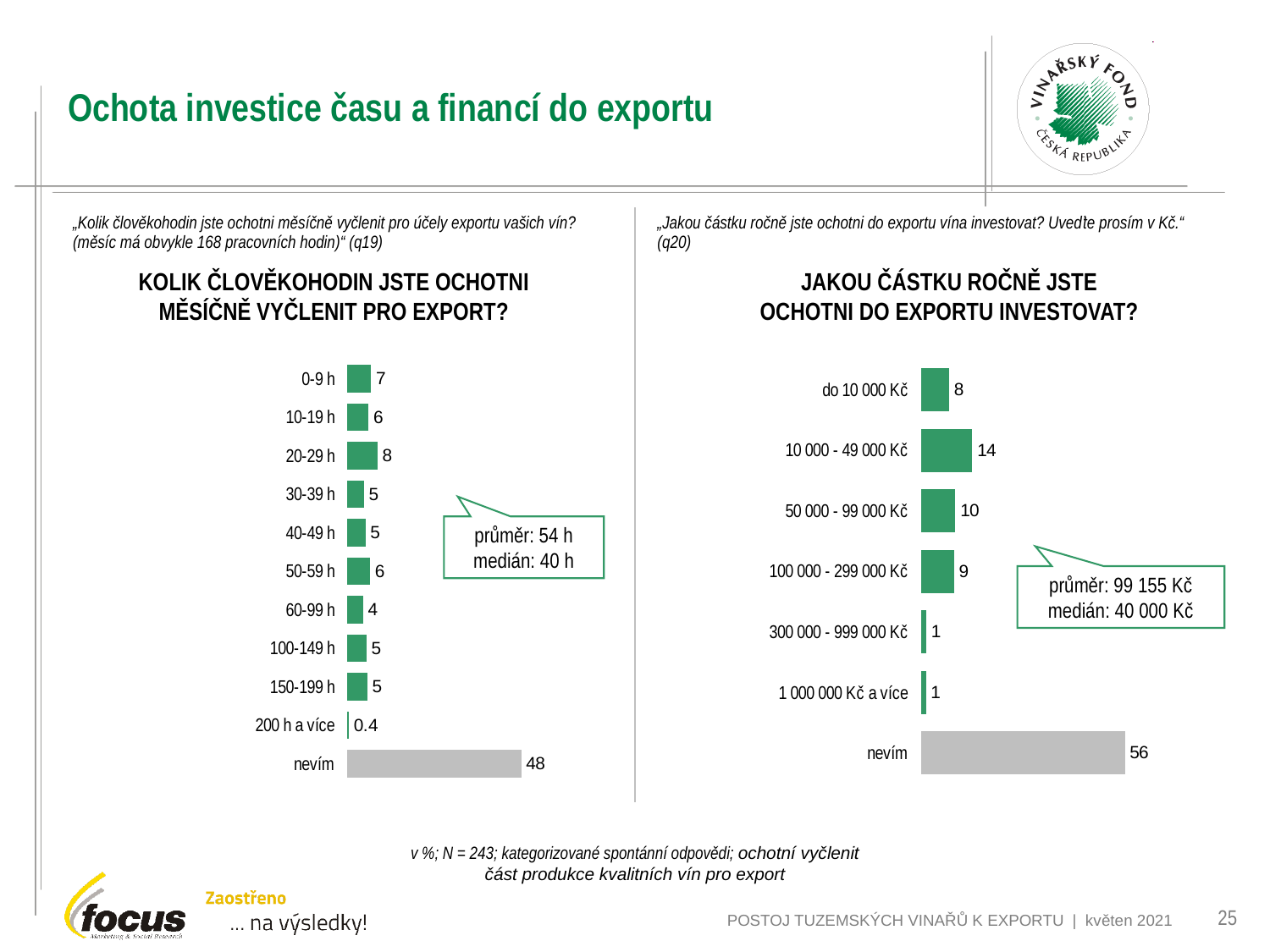
In the right chart (JAKOU ČÁSTKU ROČNĚ JSTE OCHOTNI DO EXPORTU INVESTOVAT?), which is larger, the value for 50 000 - 99 000 Kč or the value for 100 000 - 299 000 Kč? 50 000 - 99 000 Kč In the left chart (KOLIK ČLOVĚKOHODIN JSTE OCHOTNI MĚSÍČNĚ VYČLENIT PRO EXPORT?), what is the value for 20-29 h? 8 What type of chart is the right chart (JAKOU ČÁSTKU ROČNĚ JSTE OCHOTNI DO EXPORTU INVESTOVAT?)? bar chart In the right chart (JAKOU ČÁSTKU ROČNĚ JSTE OCHOTNI DO EXPORTU INVESTOVAT?), what is the value for nevím? 56 In the right chart (JAKOU ČÁSTKU ROČNĚ JSTE OCHOTNI DO EXPORTU INVESTOVAT?), what is the value for 10 000 - 49 000 Kč? 14 In the left chart (KOLIK ČLOVĚKOHODIN JSTE OCHOTNI MĚSÍČNĚ VYČLENIT PRO EXPORT?), what is the value for 200 h a více? 0.4 In the right chart (JAKOU ČÁSTKU ROČNĚ JSTE OCHOTNI DO EXPORTU INVESTOVAT?), how many categories are shown? 7 In the left chart (KOLIK ČLOVĚKOHODIN JSTE OCHOTNI MĚSÍČNĚ VYČLENIT PRO EXPORT?), which category has the highest value? nevím In the right chart (JAKOU ČÁSTKU ROČNĚ JSTE OCHOTNI DO EXPORTU INVESTOVAT?), what is the difference between the values for 10 000 - 49 000 Kč and do 10 000 Kč? 6 In the left chart (KOLIK ČLOVĚKOHODIN JSTE OCHOTNI MĚSÍČNĚ VYČLENIT PRO EXPORT?), what is the difference between the values for nevím and 0-9 h? 41 In the left chart (KOLIK ČLOVĚKOHODIN JSTE OCHOTNI MĚSÍČNĚ VYČLENIT PRO EXPORT?), how many categories are shown? 11 In the left chart (KOLIK ČLOVĚKOHODIN JSTE OCHOTNI MĚSÍČNĚ VYČLENIT PRO EXPORT?), which category has the lowest value? 200 h a více